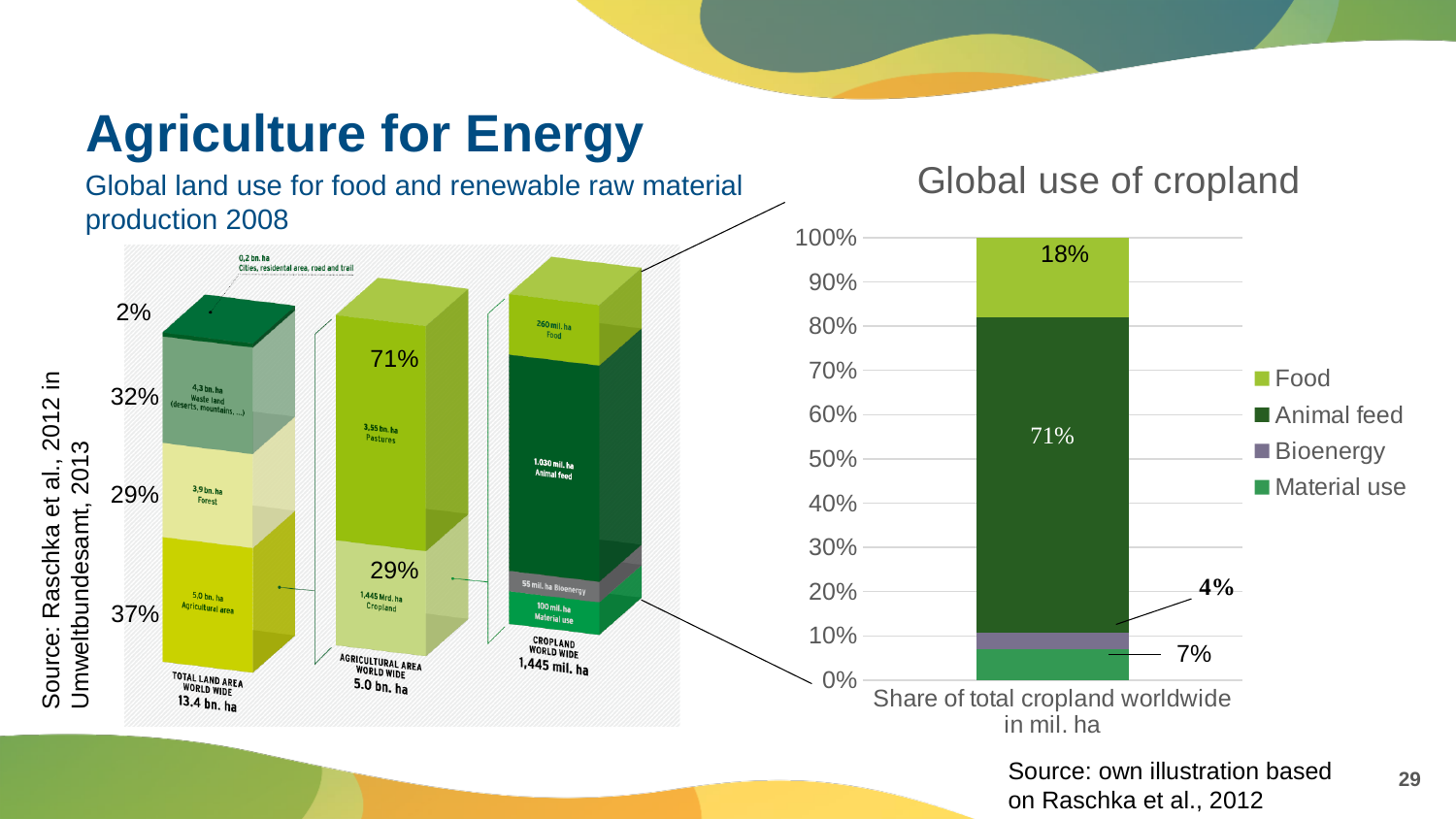
In the 'Global use of cropland' chart, which use accounts for the smallest share of cropland? Bioenergy In the 'Global use of cropland' chart, what is the combined share of bioenergy and material use? 11% In the 'Global use of cropland' chart, how many percentage points larger is the animal feed share than the food share? 53 In the 'Global use of cropland' chart, what share of cropland is used for bioenergy? 4% In the 'Global use of cropland' chart, which use accounts for the largest share of cropland? Animal feed What is the x-axis label of the 'Global use of cropland' chart? Share of total cropland worldwide in mil. ha What kind of chart is 'Global use of cropland'? Stacked bar chart In the 'Global use of cropland' chart, what share of cropland is used for material use? 7% In the 'Global use of cropland' chart, what share of cropland is used for animal feed? 71% How many series does the legend of the 'Global use of cropland' chart list? 4 In the 'Global use of cropland' chart, which is larger: the share for material use or the share for bioenergy? Material use In the 'Global use of cropland' chart, what share of cropland is used for food? 18%